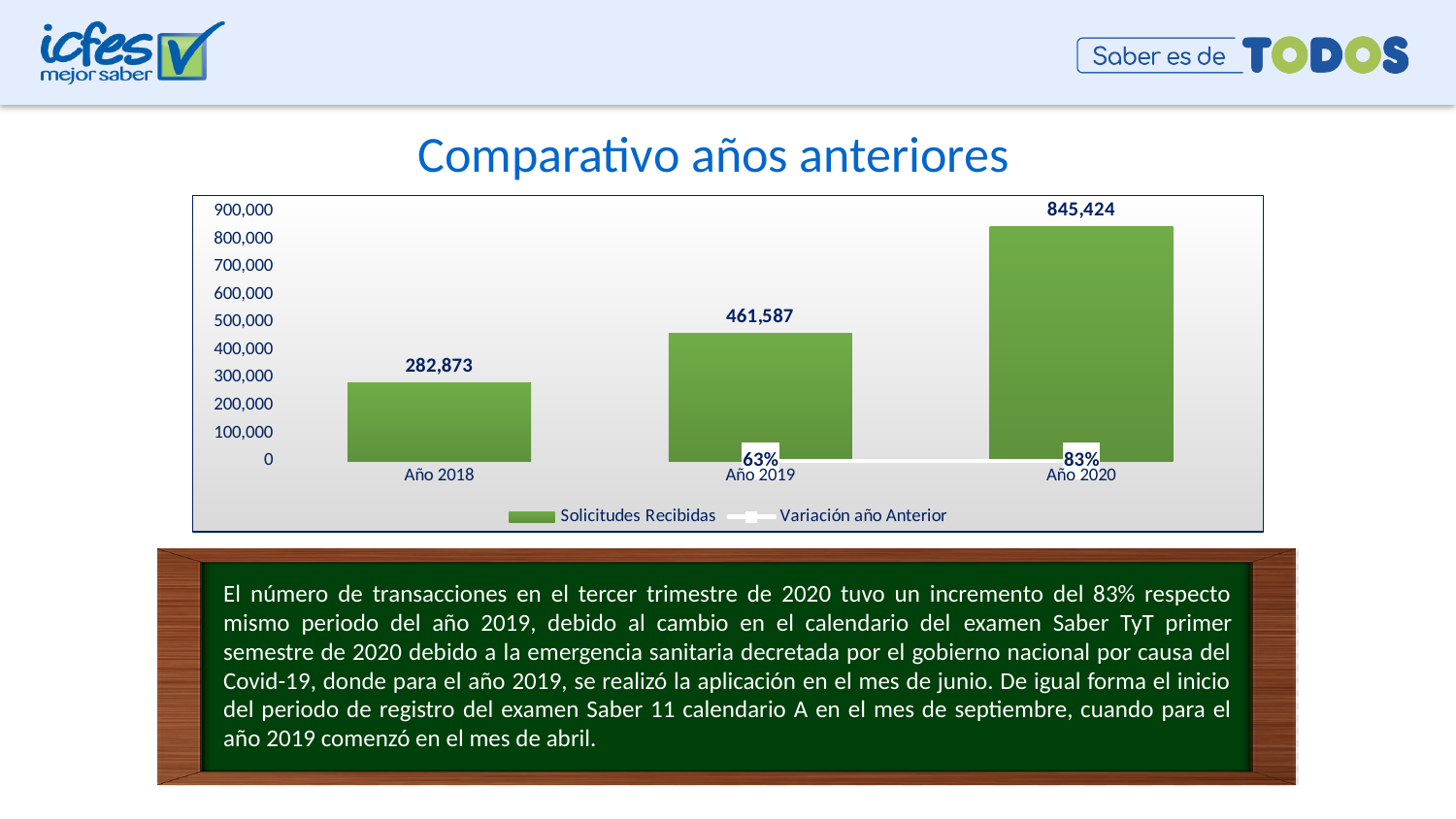
What is the difference in Solicitudes Recibidas between Año 2020 and Año 2019? 383,837 How many series does the chart legend list? 2 What is the value of Solicitudes Recibidas for Año 2019? 461,587 What is the title of the chart? Comparativo años anteriores What is the Variación año Anterior shown for Año 2020? 83% Which year has the highest number of Solicitudes Recibidas? Año 2020 Which is larger, the Solicitudes Recibidas for Año 2019 or for Año 2018? Año 2019 What is the value of Solicitudes Recibidas for Año 2018? 282,873 How many years are shown on the x axis of the chart? 3 Do the Solicitudes Recibidas values rise or fall from Año 2018 to Año 2020? rise Which year has the lowest number of Solicitudes Recibidas? Año 2018 What is the Variación año Anterior shown for Año 2019? 63%